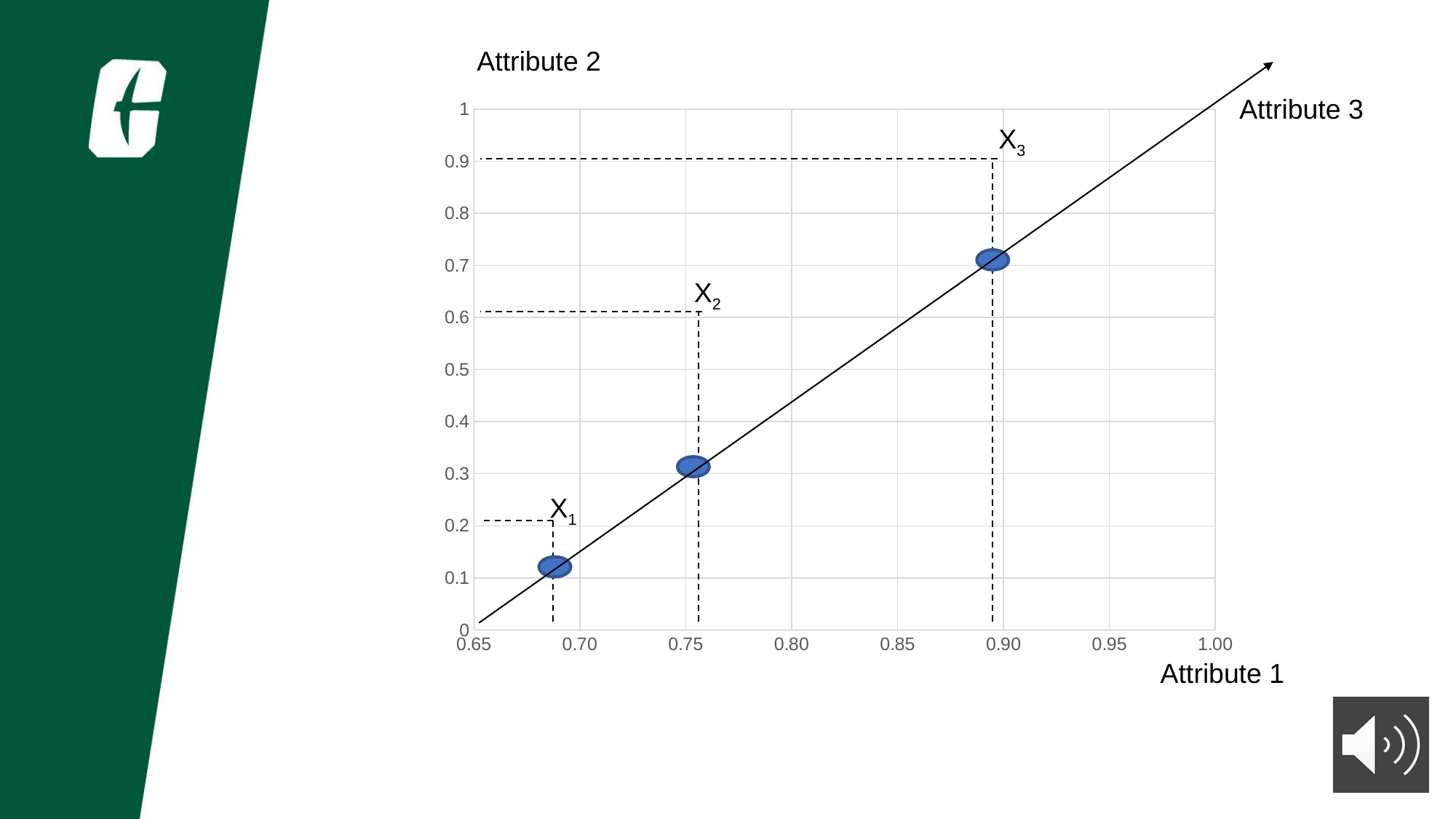
Is the Attribute 1 value for X3 greater or less than 0.85? greater Which point has the lowest Attribute 2 value? X1 Is the Attribute 2 value for X3 greater or less than 0.6? greater How many data points are plotted on the chart? 3 What is the label of the horizontal axis? Attribute 1 Do the Attribute 2 values of the points rise or fall as Attribute 1 increases? rise What kind of chart is shown on the slide? scatter chart Which point has the larger Attribute 1 value, X1 or X2? X2 Which point has the highest Attribute 2 value? X3 Is the Attribute 1 value for X2 greater or less than 0.80? less